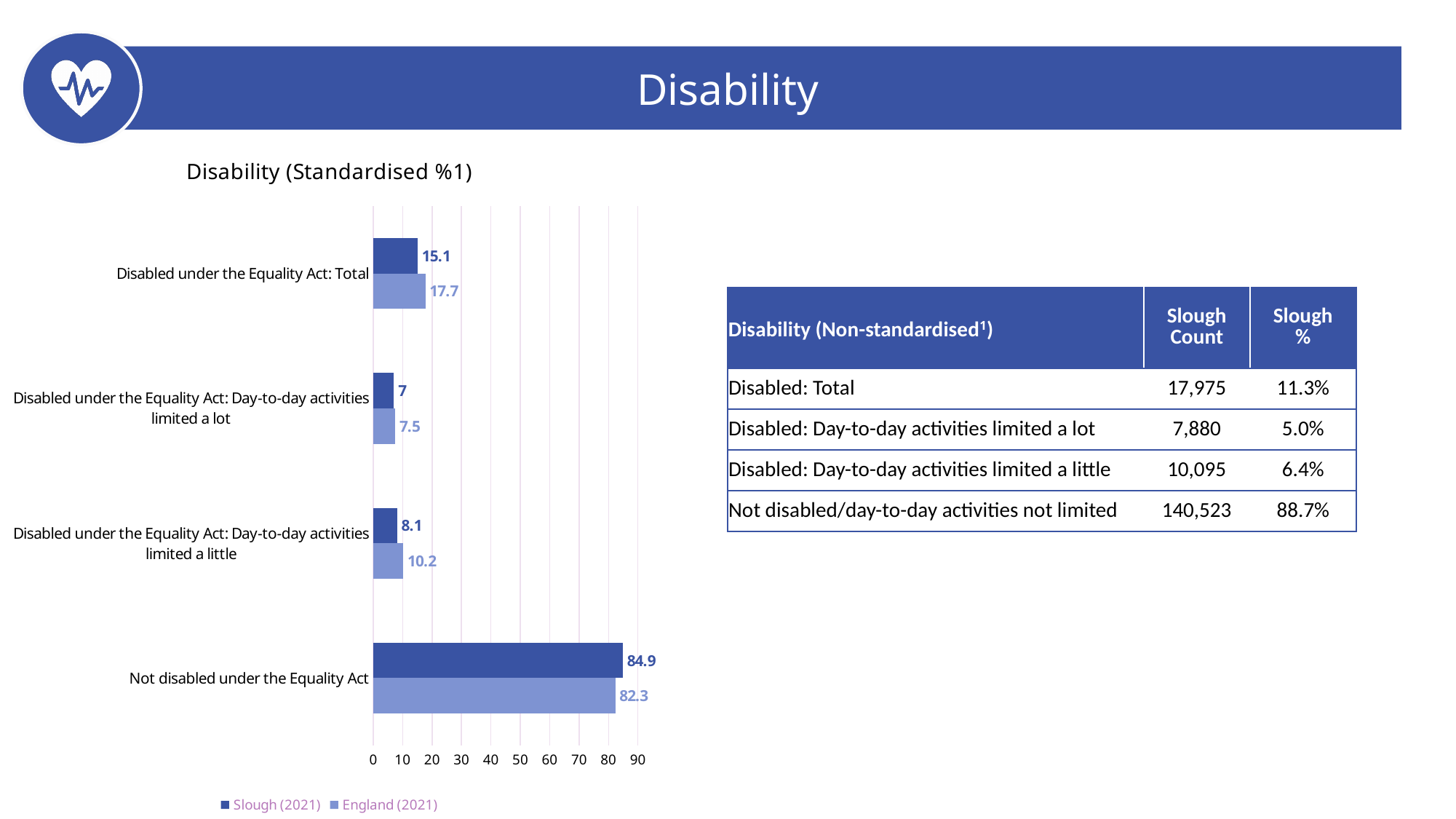
How many series does the chart legend list? 2 What is the England (2021) value for 'Not disabled under the Equality Act'? 82.3 What is the difference between the England (2021) and Slough (2021) values for 'Disabled under the Equality Act: Total'? 2.6 Is the Slough (2021) value for 'Not disabled under the Equality Act' greater or less than 80? greater What is the title of the chart? Disability (Standardised %1) What kind of chart is shown on the slide? bar chart Which category has the highest Slough (2021) value? Not disabled under the Equality Act For 'Not disabled under the Equality Act', which series has the larger value, Slough (2021) or England (2021)? Slough (2021) How many categories are shown on the chart? 4 What is the Slough (2021) value for 'Disabled under the Equality Act: Total'? 15.1 Which category has the lowest England (2021) value? Disabled under the Equality Act: Day-to-day activities limited a lot What is the England (2021) value for 'Disabled under the Equality Act: Day-to-day activities limited a little'? 10.2